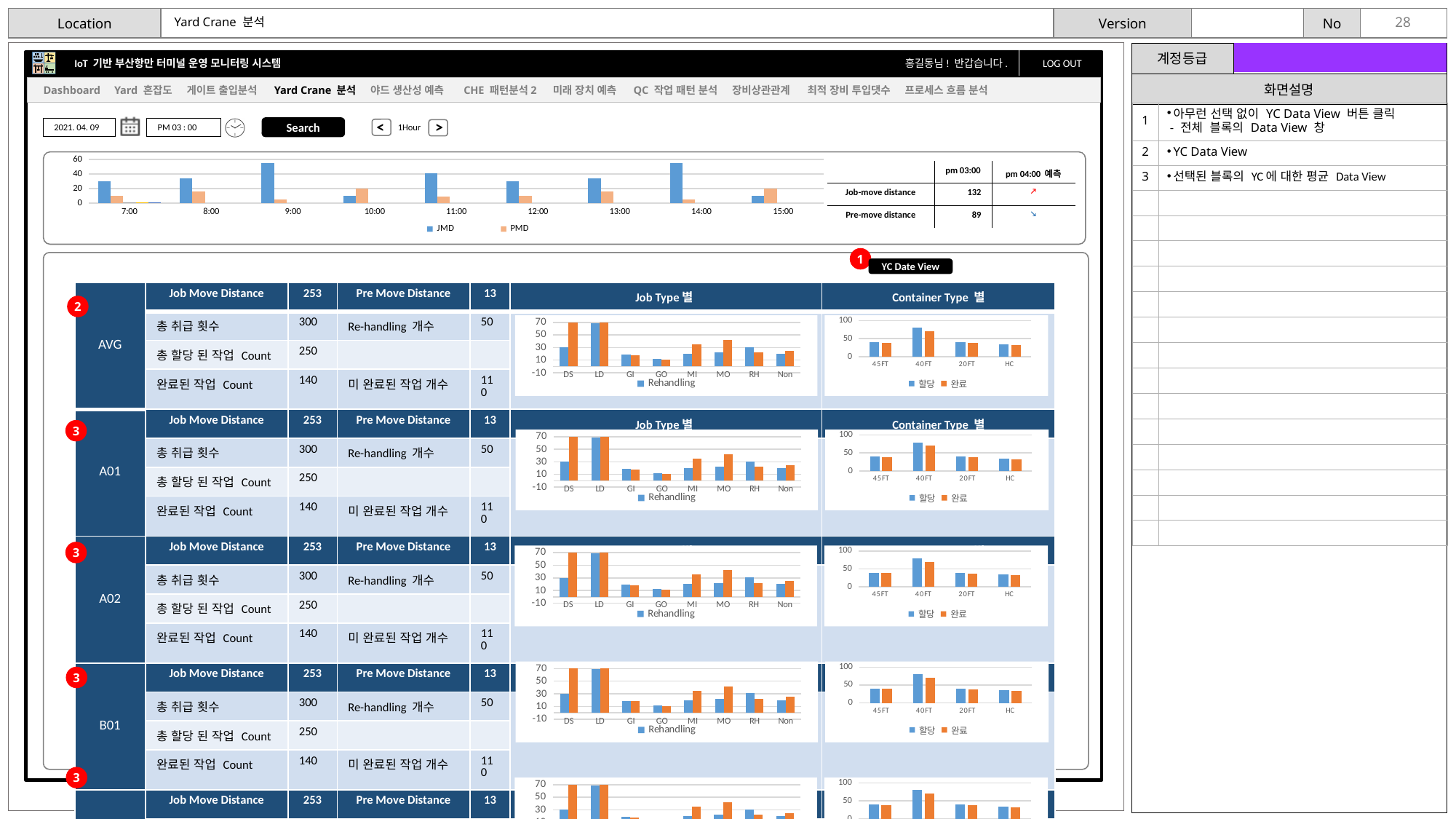
In the 'Job Type 별' chart of the AVG row, how many job type categories are on the x axis? 8 In the top JMD/PMD chart, is the JMD value at 9:00 greater or less than 40? greater In the 'Container Type 별' chart of the AVG row, is the 할당 value for 40FT greater or less than 50? greater In the 'Container Type 별' chart of the AVG row, which container type has the highest bar? 40FT What are the two legend entries of the 'Container Type 별' chart in the AVG row? 할당, 완료 In the top JMD/PMD chart, which is larger at 7:00, JMD or PMD? JMD In the top JMD/PMD chart, which is larger at 15:00, JMD or PMD? PMD In the top JMD/PMD chart, is the PMD value at 9:00 greater or less than 20? less What kind of chart is the top chart showing JMD and PMD by hour? bar chart How many series does the legend of the top JMD/PMD chart list? 2 How many hourly categories are shown on the x axis of the top JMD/PMD chart? 9 In the 'Job Type 별' chart of the AVG row, which category has the lowest bars? GO